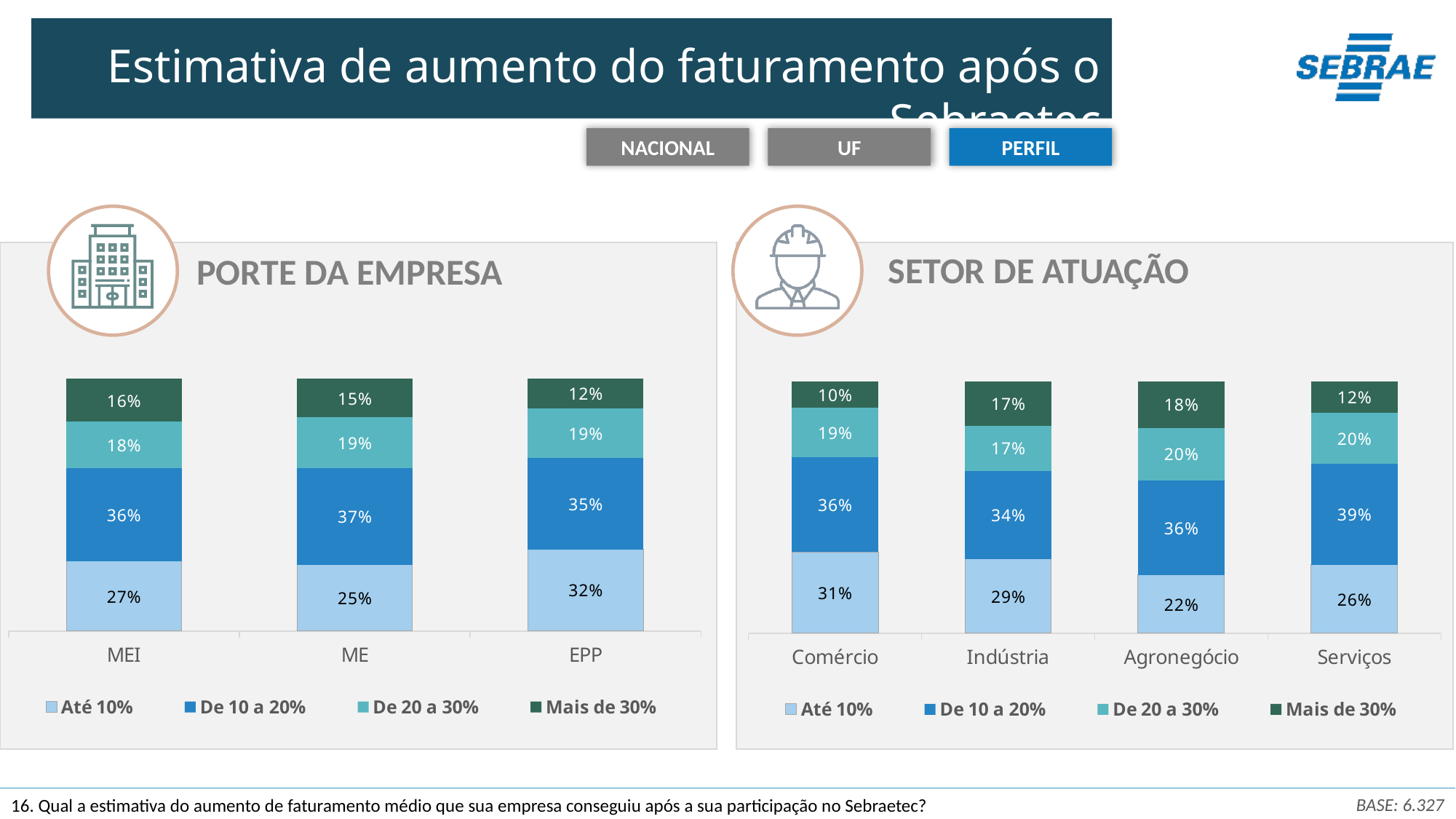
In the SETOR DE ATUAÇÃO chart, what is the value of the 'Até 10%' segment for Agronegócio? 22% In the SETOR DE ATUAÇÃO chart, what is the difference between the 'Mais de 30%' values for Indústria and Comércio? 7% In the PORTE DA EMPRESA chart, what is the value of the 'Até 10%' segment for EPP? 32% In the PORTE DA EMPRESA chart, which category has the lowest 'Até 10%' value? ME In the SETOR DE ATUAÇÃO chart, what is the value of the 'De 10 a 20%' segment for Serviços? 39% In the PORTE DA EMPRESA chart, what is the value of the 'Mais de 30%' segment for MEI? 16% In the SETOR DE ATUAÇÃO chart, what is the difference between the 'Até 10%' values for Comércio and Agronegócio? 9% What type of chart is the SETOR DE ATUAÇÃO chart? Stacked bar chart How many categories are shown on the x axis of the SETOR DE ATUAÇÃO chart? 4 In the PORTE DA EMPRESA chart, which is larger: the 'De 10 a 20%' value for ME or for EPP? ME In the SETOR DE ATUAÇÃO chart, which category has the highest 'Mais de 30%' value? Agronegócio How many series does the legend of the PORTE DA EMPRESA chart list? 4